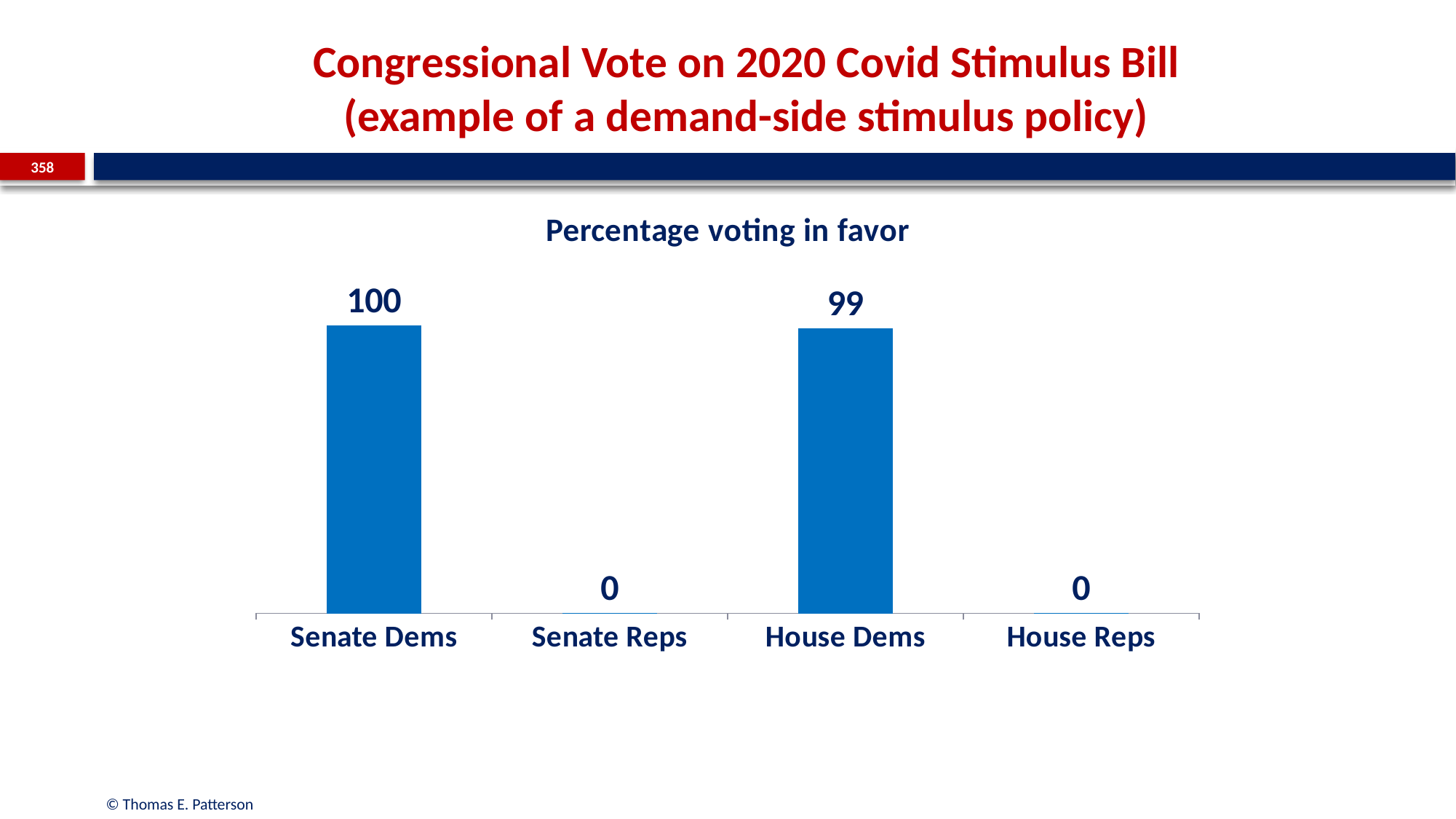
What is the difference between the values for Senate Dems and House Dems? 1 What is the value for Senate Dems? 100 What is the value for House Reps? 0 Which category has the highest value? Senate Dems What kind of chart is shown on the slide? bar chart How many categories are shown on the x axis? 4 What is the value for House Dems? 99 What is the value for Senate Reps? 0 What is the title of the chart? Percentage voting in favor Which is larger, the value for Senate Dems or the value for Senate Reps? Senate Dems What is the difference between the values for House Dems and House Reps? 99 What colour are the bars in the chart? blue